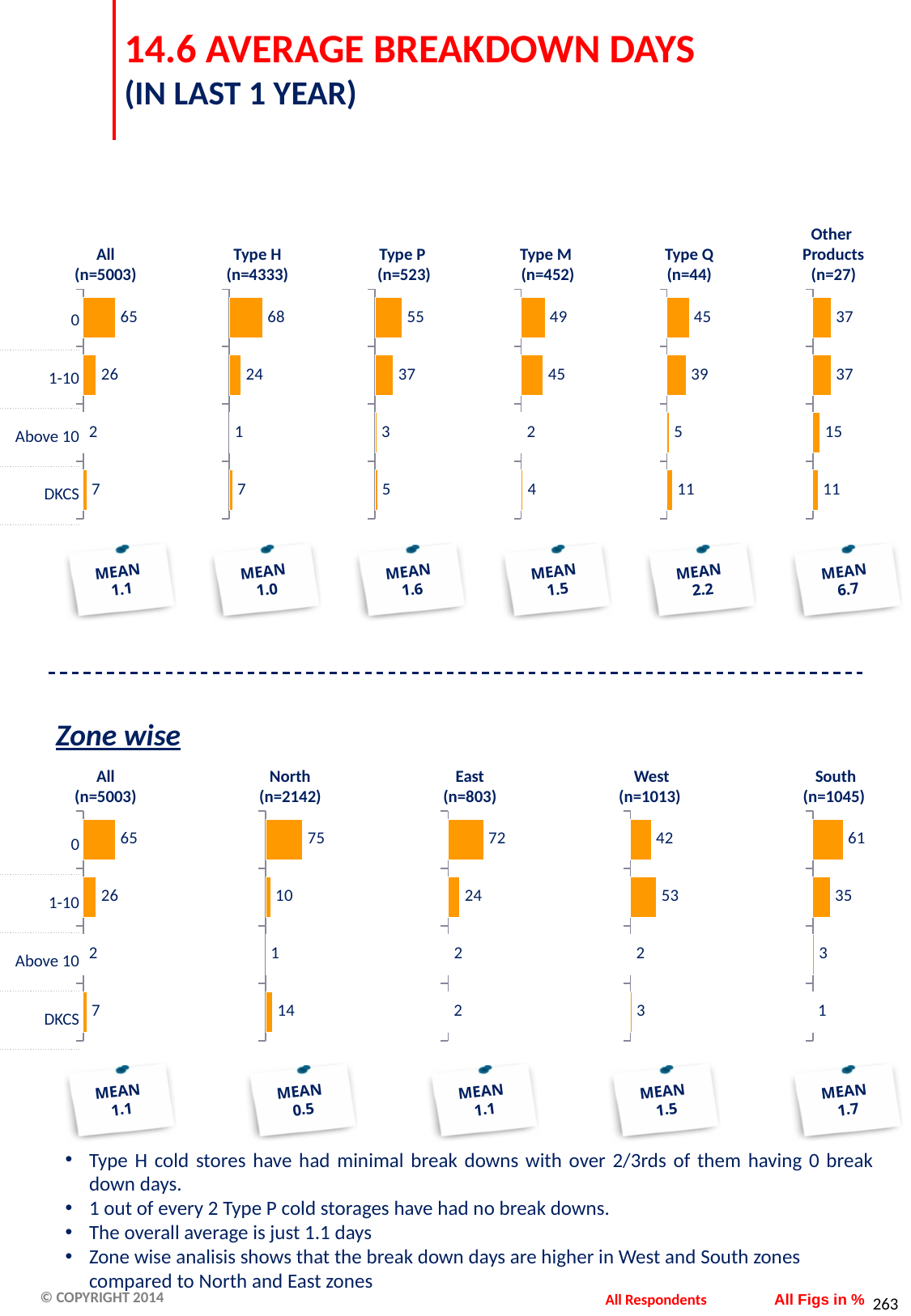
In the top (type-wise) charts, what is the difference between the 0-days value for Type H and Type M? 19 In the Zone wise charts, which zone has the highest value for 0 breakdown days? North In the top (type-wise) charts, what is the value for '1-10' breakdown days for Type P? 37 In the top (type-wise) charts, what is the MEAN shown for Type Q? 2.2 In the top (type-wise) charts, which type has the highest value for 0 breakdown days? Type H In the top (type-wise) charts, what percentage of Type H cold stores had 0 breakdown days? 68 In the top (type-wise) charts, which group has the lowest value for 0 breakdown days? Other Products In the Zone wise charts, what is the value for '1-10' breakdown days in the West zone? 53 How many breakdown-day categories are shown in each of the small charts? 4 In the Zone wise charts, is the DKCS value larger for North or for East? North In the top (type-wise) charts, what is the value for 'Above 10' for Other Products? 15 In the Zone wise charts, what is the MEAN shown for the South zone? 1.7